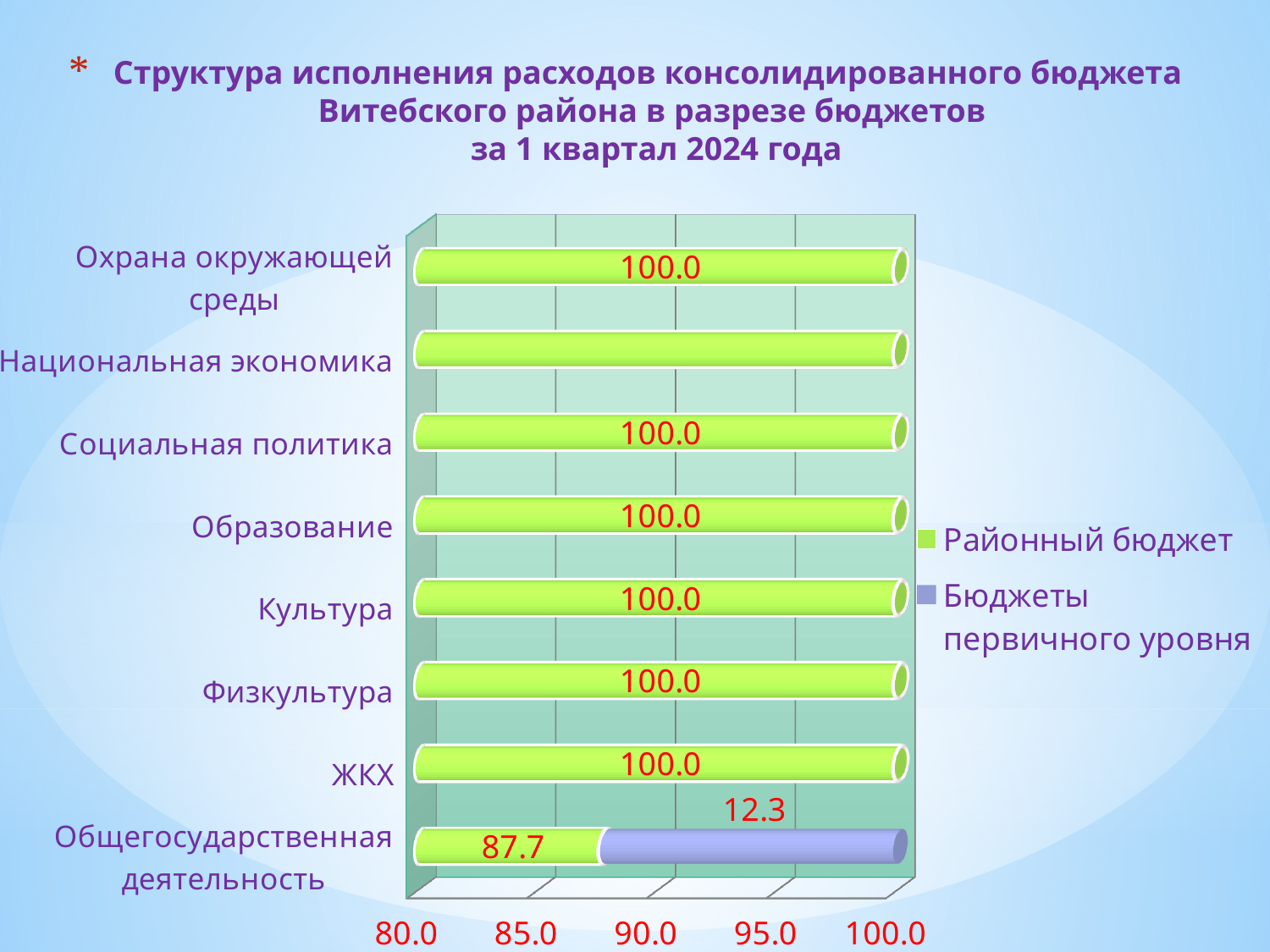
What kind of chart is shown on the slide? bar chart Which series is shown in green in the legend? Районный бюджет What is the difference between the Районный бюджет values for Культура and Общегосударственная деятельность? 12.3 Which category has the lowest value for Районный бюджет? Общегосударственная деятельность What is the value of Районный бюджет for ЖКХ? 100.0 How many series does the legend list? 2 What is the value of Районный бюджет for Общегосударственная деятельность? 87.7 What is the value of Районный бюджет for Образование? 100.0 Which is larger: the Районный бюджет value for Физкультура or for Общегосударственная деятельность? Физкультура What is the value of Бюджеты первичного уровня for Общегосударственная деятельность? 12.3 How many categories are listed on the vertical axis of the chart? 8 Is the Районный бюджет value for Общегосударственная деятельность greater or less than 90.0? less